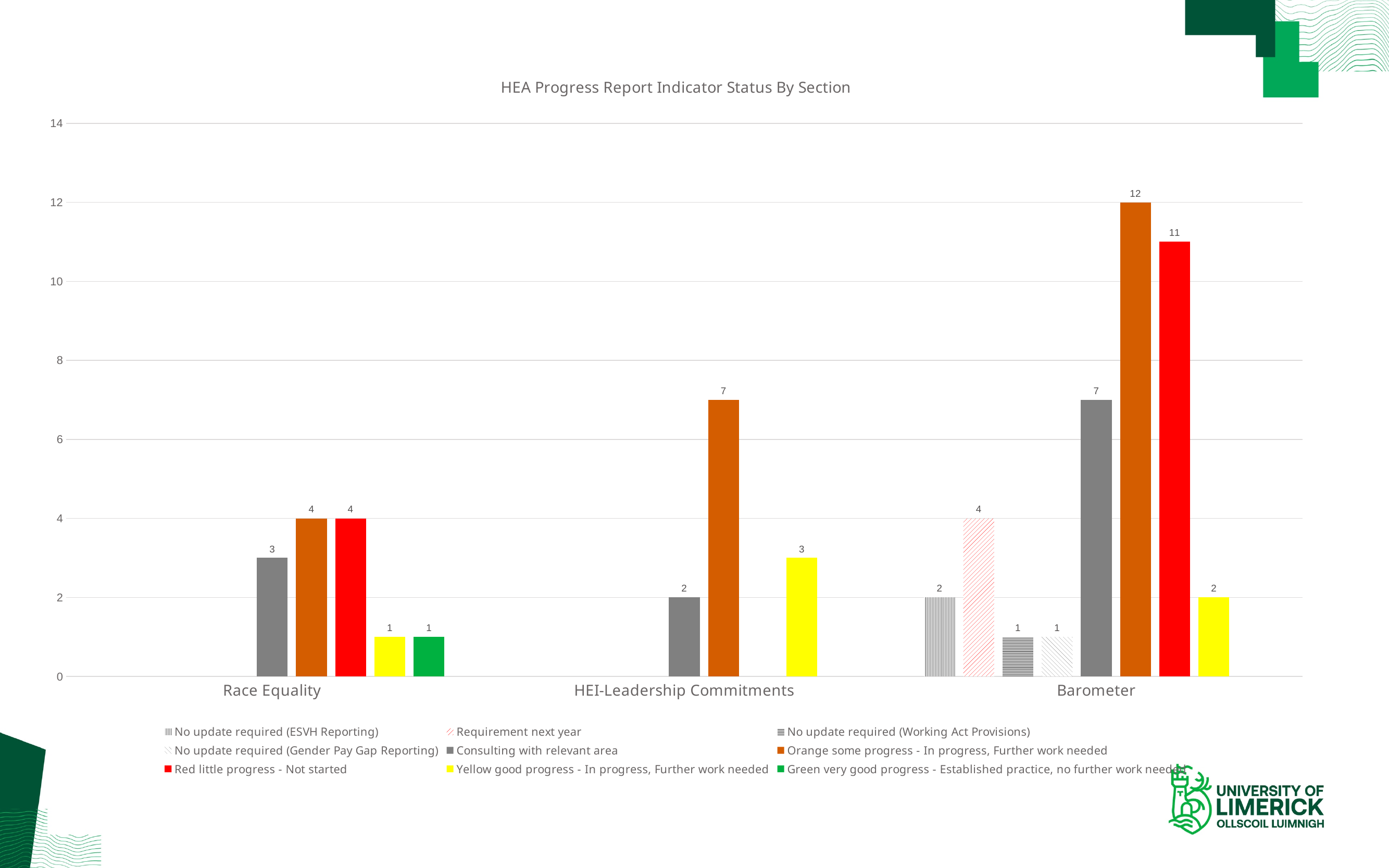
Which is larger for HEI-Leadership Commitments: 'Orange some progress' or 'Yellow good progress'? Orange some progress What kind of chart is shown? Bar chart What is the value of 'Orange some progress - In progress, Further work needed' for Barometer? 12 What is the title of the chart? HEA Progress Report Indicator Status By Section What is the value of 'Consulting with relevant area' for HEI-Leadership Commitments? 2 Which section has the highest value for 'Orange some progress - In progress, Further work needed'? Barometer What is the difference between the 'Orange some progress' and 'Red little progress' values for Barometer? 1 Which section has the lowest value for 'Consulting with relevant area'? HEI-Leadership Commitments What is the value of 'Red little progress - Not started' for Race Equality? 4 How many sections are shown on the x axis? 3 How many series does the legend list? 9 What is the value of 'Requirement next year' for Barometer? 4